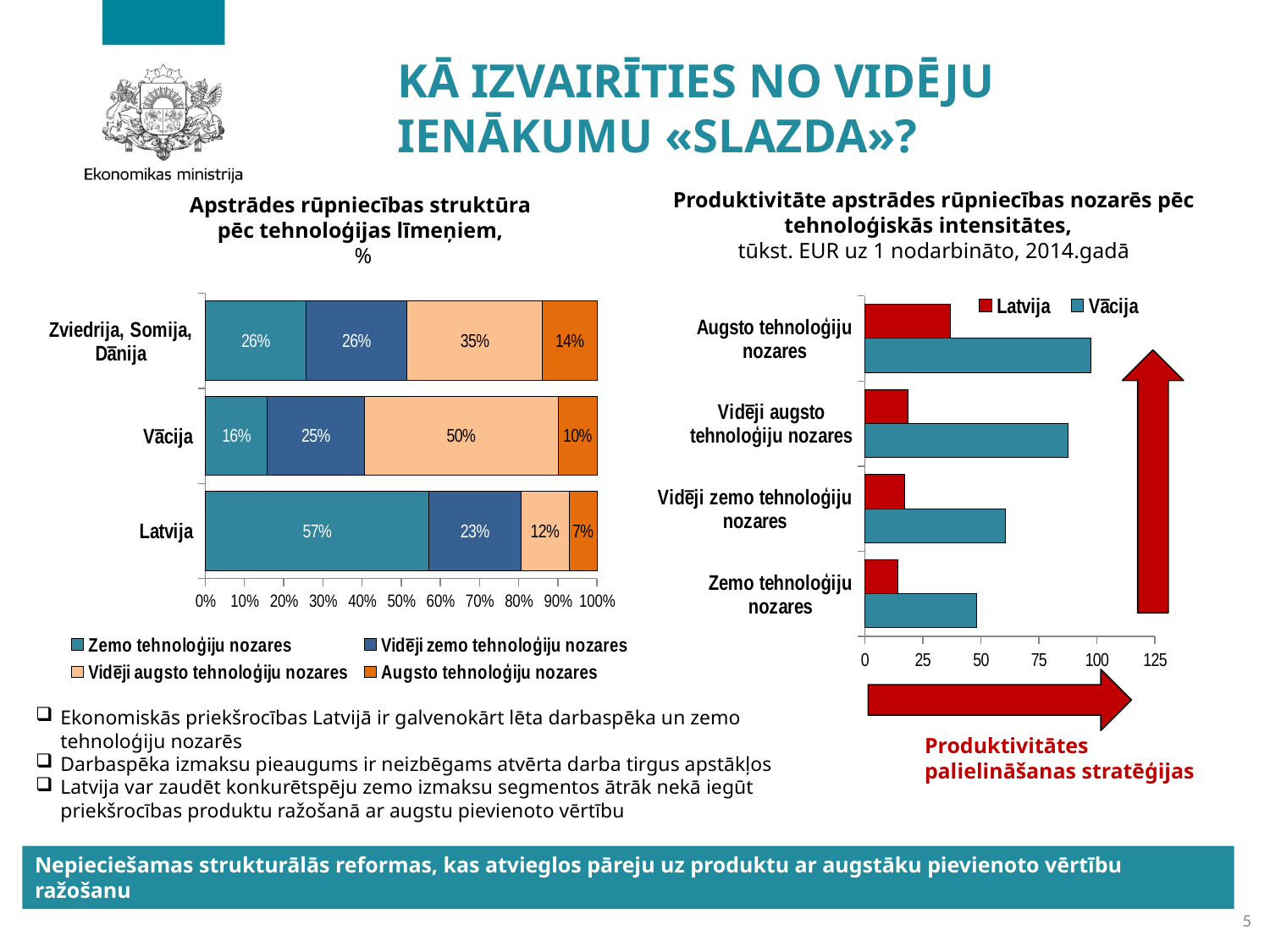
In the left chart (Apstrādes rūpniecības struktūra pēc tehnoloģijas līmeņiem), which country group has the highest share of Zemo tehnoloģiju nozares? Latvija In the left chart (Apstrādes rūpniecības struktūra pēc tehnoloģijas līmeņiem), what is the difference between the Augsto tehnoloģiju nozares share for Zviedrija, Somija, Dānija and for Latvija? 7 percentage points In the right chart (Produktivitāte apstrādes rūpniecības nozarēs pēc tehnoloģiskās intensitātes), is the value for Vācija in Augsto tehnoloģiju nozares greater or less than 75? greater In the left chart (Apstrādes rūpniecības struktūra pēc tehnoloģijas līmeņiem), what is the share of Augsto tehnoloģiju nozares for Zviedrija, Somija, Dānija? 14% In the right chart (Produktivitāte apstrādes rūpniecības nozarēs pēc tehnoloģiskās intensitātes), how many categories are shown? 4 In the left chart (Apstrādes rūpniecības struktūra pēc tehnoloģijas līmeņiem), what is the share of Zemo tehnoloģiju nozares for Latvija? 57% In the right chart (Produktivitāte apstrādes rūpniecības nozarēs pēc tehnoloģiskās intensitātes), how many series does the legend list? 2 In the left chart (Apstrādes rūpniecības struktūra pēc tehnoloģijas līmeņiem), what is the share of Vidēji augsto tehnoloģiju nozares for Vācija? 50% What kind of chart is the left chart (Apstrādes rūpniecības struktūra pēc tehnoloģijas līmeņiem)? Stacked bar chart In the right chart (Produktivitāte apstrādes rūpniecības nozarēs pēc tehnoloģiskās intensitātes), which series has the higher value in Vidēji augsto tehnoloģiju nozares, Latvija or Vācija? Vācija In the right chart (Produktivitāte apstrādes rūpniecības nozarēs pēc tehnoloģiskās intensitātes), is the value for Latvija in Zemo tehnoloģiju nozares greater or less than 25? less In the left chart (Apstrādes rūpniecības struktūra pēc tehnoloģijas līmeņiem), how many series does the legend list? 4